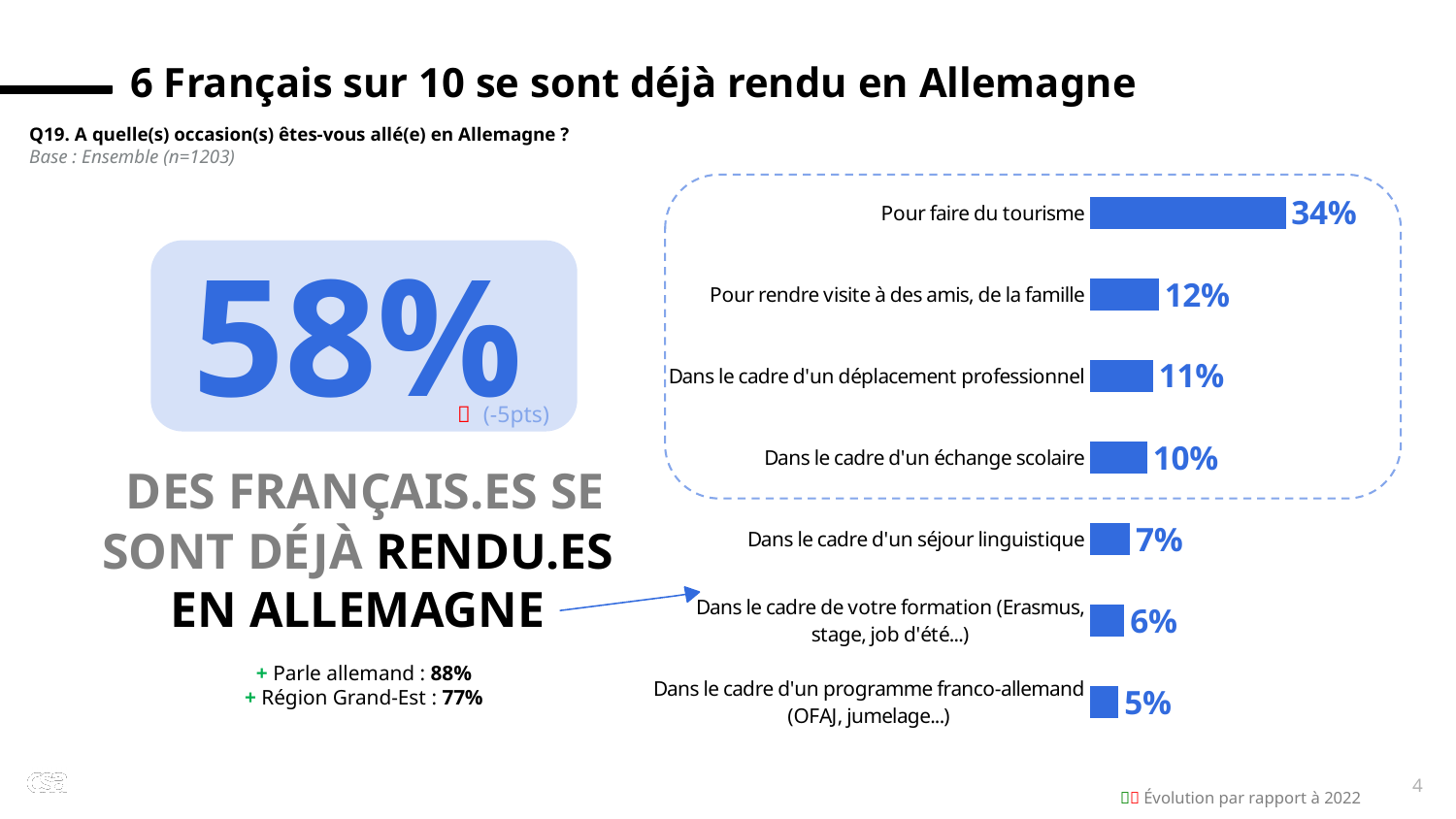
What is the difference between "Dans le cadre de votre formation (Erasmus, stage, job d'été...)" and "Dans le cadre d'un programme franco-allemand (OFAJ, jumelage...)"? 1% Which is larger: "Dans le cadre d'un déplacement professionnel" or "Dans le cadre d'un séjour linguistique"? Dans le cadre d'un déplacement professionnel What large percentage is highlighted on the left of the slide? 58% Which category has the lowest value? Dans le cadre d'un programme franco-allemand (OFAJ, jumelage...) What is the value for "Pour rendre visite à des amis, de la famille"? 12% How many categories are shown in the bar chart? 7 Which category has the highest value? Pour faire du tourisme What is the value for "Pour faire du tourisme"? 34% What kind of chart is shown on the slide? Bar chart What is the difference between "Pour faire du tourisme" and "Pour rendre visite à des amis, de la famille"? 22% What is the value for "Dans le cadre d'un échange scolaire"? 10% What is the value for "Dans le cadre d'un programme franco-allemand (OFAJ, jumelage...)"? 5%